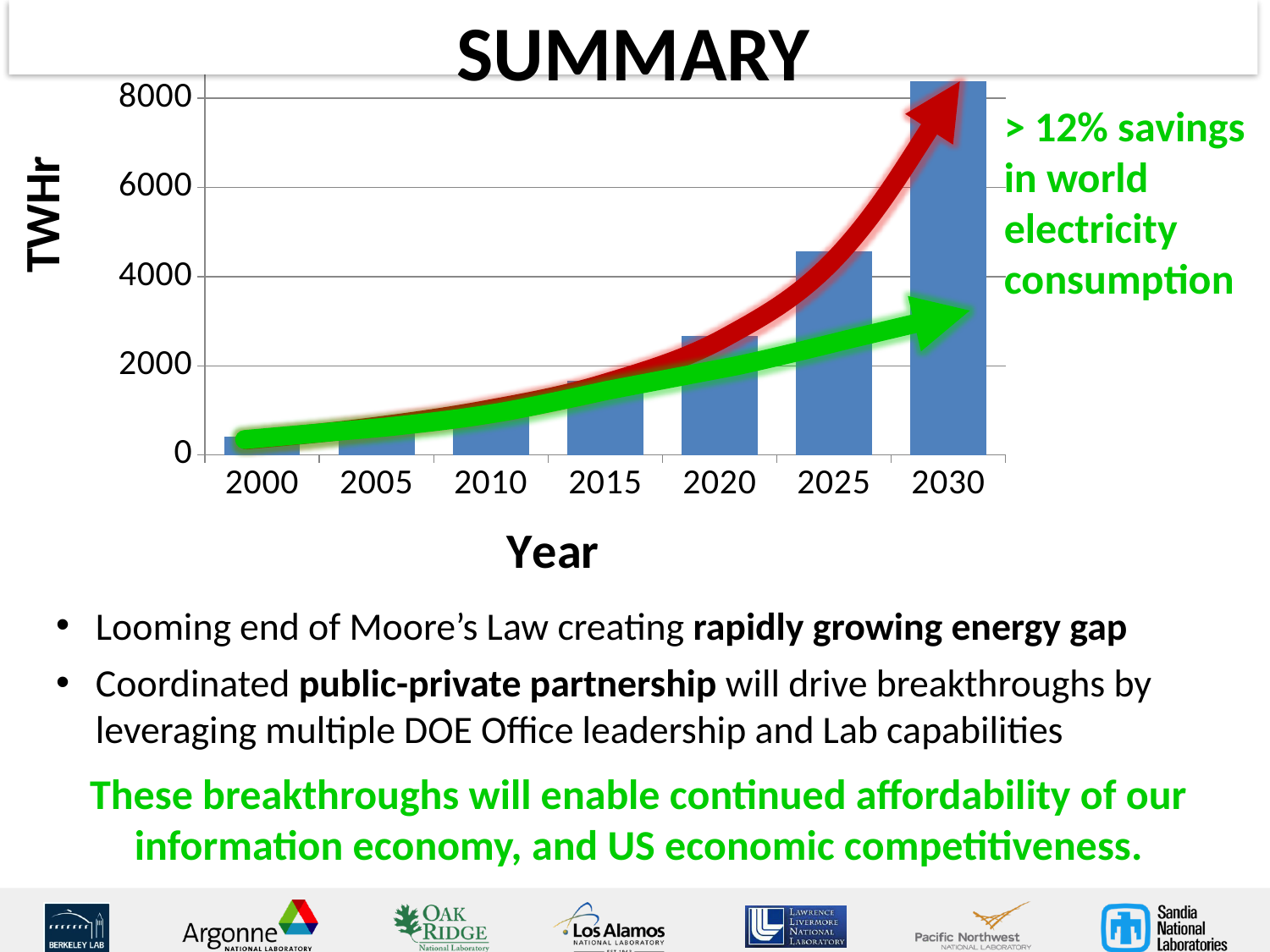
What kind of chart is shown on the slide? bar chart Which year has the lowest value on the chart? 2000 How many years (bars) are plotted on the chart? 7 Is the value for 2030 greater or less than 8000? greater Which is larger, the value for 2025 or the value for 2020? 2025 What is the label on the x axis of the chart? Year Is the value for 2015 greater or less than 2000? less Which year has the highest value on the chart? 2030 Is the value for 2025 greater or less than 4000? greater What is the label on the y axis of the chart? TWHr Do the values rise or fall from 2000 to 2030? rise